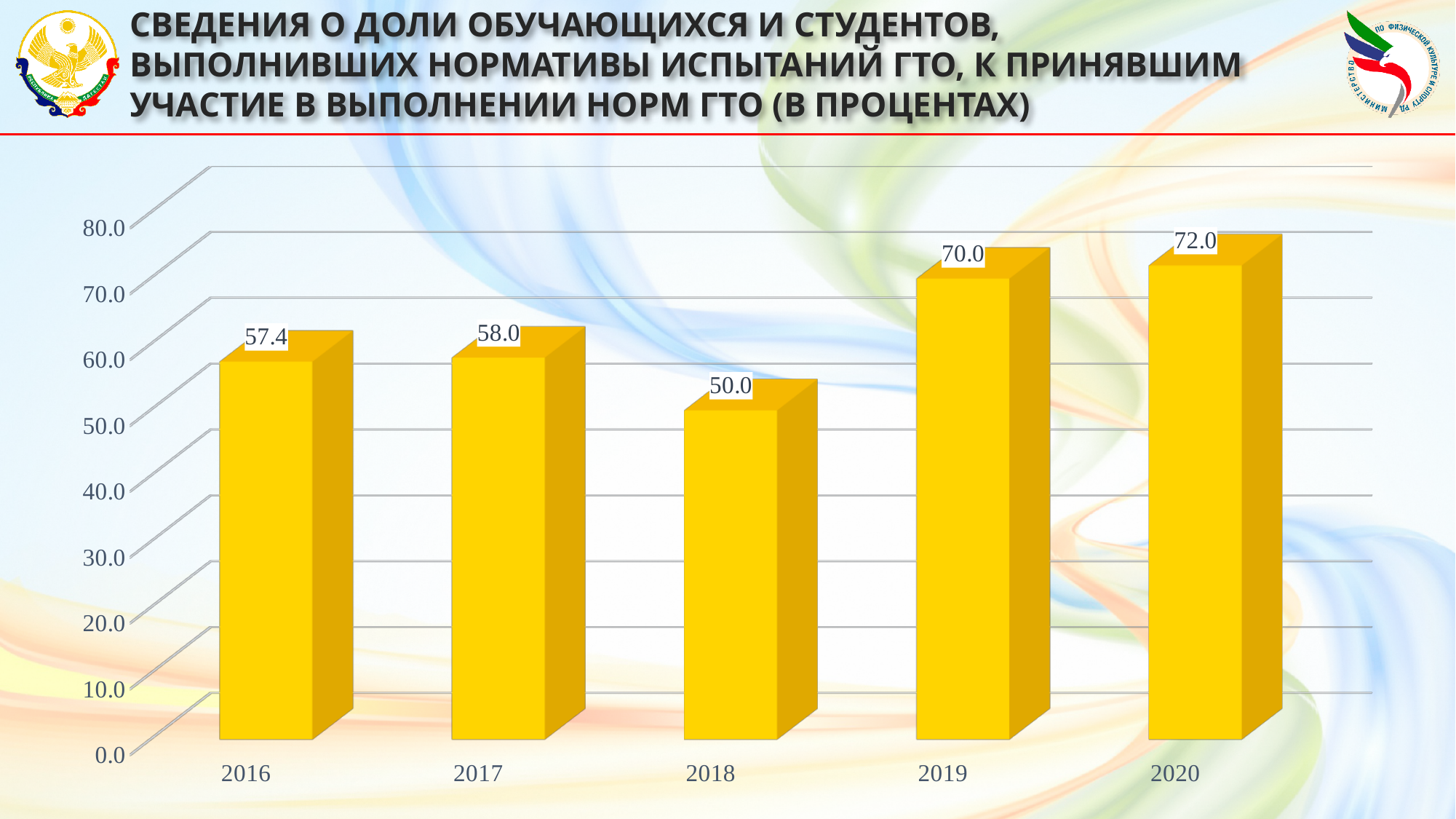
What is the difference between the values for 2019 and 2018? 20.0 Do the values rise or fall from 2018 to 2020? rise What is the value for 2020? 72.0 Is the value for 2019 greater or less than 60.0? greater Which is larger, the value for 2017 or the value for 2018? 2017 What kind of chart is shown on the slide? bar chart Which year has the highest value? 2020 Which year has the lowest value? 2018 What is the value for 2016? 57.4 How many years are shown on the x axis? 5 What is the difference between the values for 2020 and 2016? 14.6 What is the value for 2018? 50.0